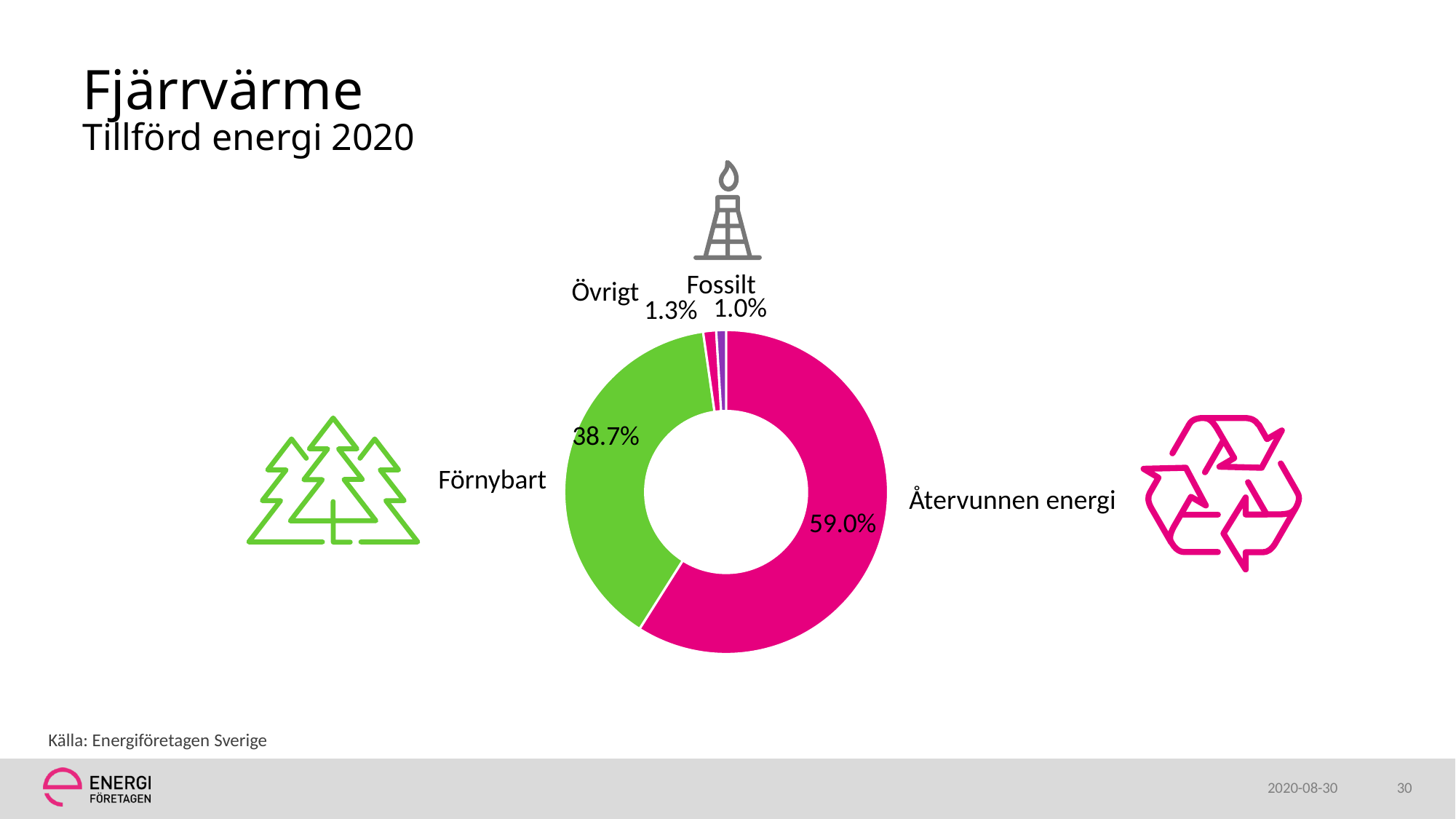
What is the value shown for Fossilt? 1.0% What is the difference in percentage points between Återvunnen energi and Förnybart? 20.3 Which category has the smallest share of the chart? Fossilt What is the combined share of Övrigt and Fossilt? 2.3% What colour is the Förnybart slice? Green What share of the pie does Återvunnen energi have? 59.0% Which is larger, Förnybart or Återvunnen energi? Återvunnen energi How many categories are shown in the chart? 4 What is the value shown for Förnybart? 38.7% What kind of chart is shown on the slide? Pie chart (doughnut) Which category has the largest share of the chart? Återvunnen energi What is the value shown for Övrigt? 1.3%